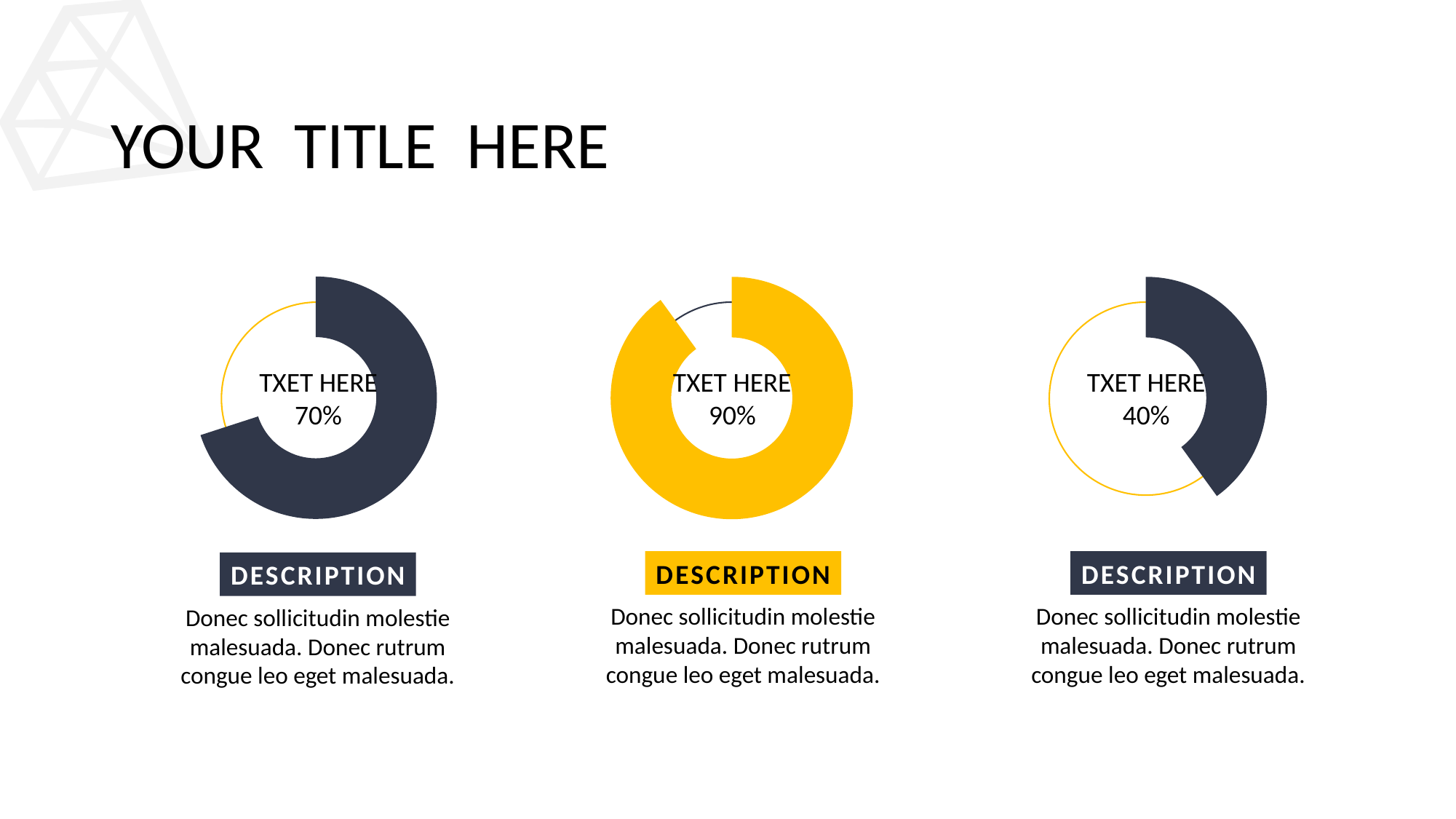
Which of the three donut charts shows the highest percentage: left, middle or right? middle What is the difference between the percentage in the middle donut chart and the percentage in the left donut chart? 20% What kind of chart is used for the three percentages on the slide? donut chart What is the difference between the percentage in the left donut chart and the percentage in the right donut chart? 30% What percentage is shown in the left donut chart? 70% What label appears above the percentage in the centre of each donut chart? TXET HERE What percentage is shown in the middle donut chart? 90% How many donut charts are on the slide? 3 What colour is the filled ring of the middle donut chart? yellow Which of the three donut charts shows the lowest percentage: left, middle or right? right What percentage is shown in the right donut chart? 40% Which is larger, the percentage in the left donut chart or the percentage in the right donut chart? left